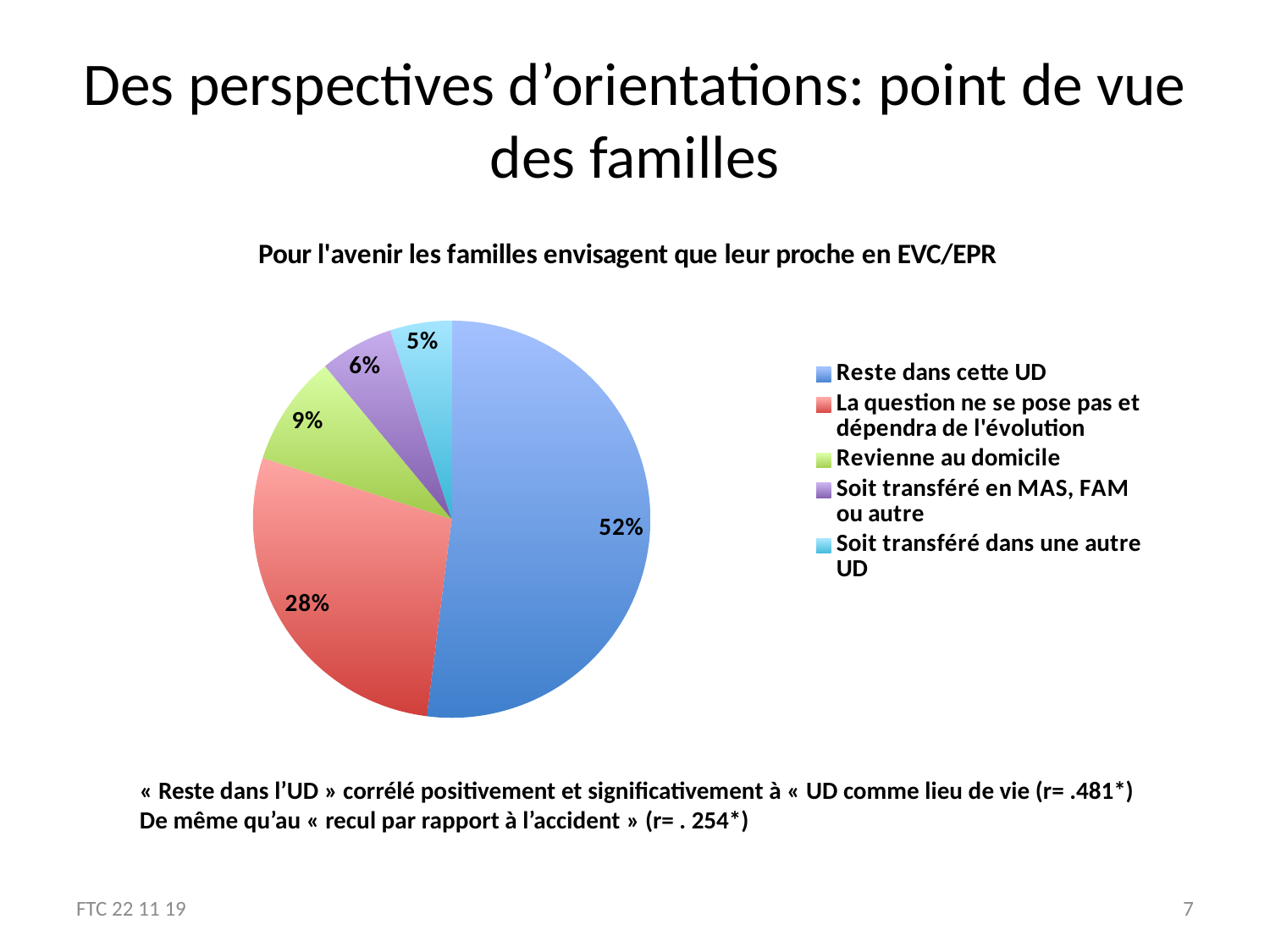
What share of the pie is 'La question ne se pose pas et dépendra de l'évolution'? 28% Which category has the smallest slice of the pie? Soit transféré dans une autre UD What is the chart's title? Pour l'avenir les familles envisagent que leur proche en EVC/EPR How many categories does the pie chart show? 5 What share of the pie is 'Soit transféré en MAS, FAM ou autre'? 6% What share of the pie is 'Reste dans cette UD'? 52% Which category has the largest slice of the pie? Reste dans cette UD What kind of chart is shown on the slide? pie chart Which is larger: the share for 'Revienne au domicile' or the share for 'Soit transféré en MAS, FAM ou autre'? Revienne au domicile What is the difference between the shares for 'Reste dans cette UD' and 'La question ne se pose pas et dépendra de l'évolution'? 24%